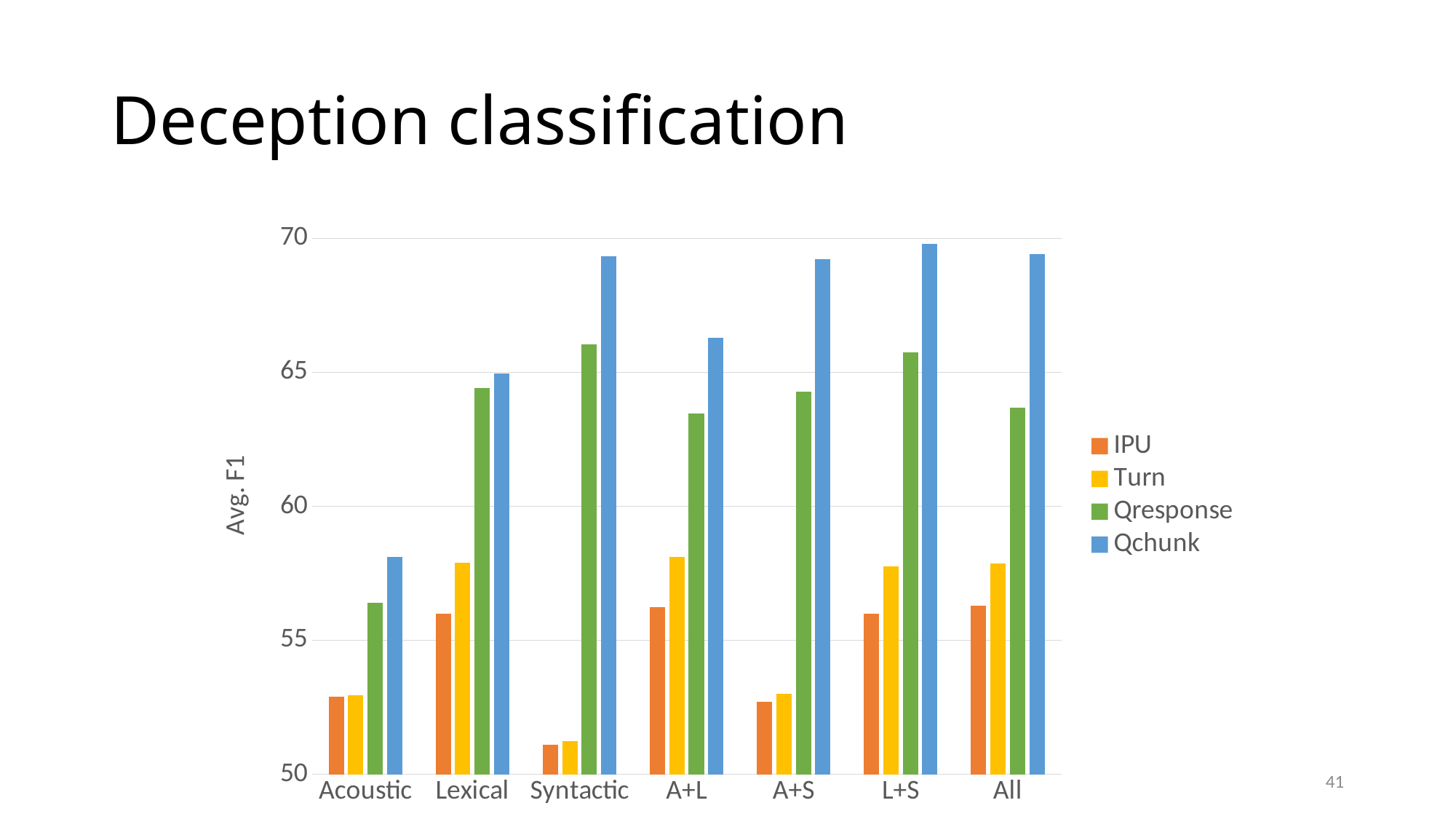
What kind of chart is shown on the slide? bar chart How many categories are shown on the x axis? 7 What is the label of the y axis? Avg. F1 Is the Qchunk value for Acoustic greater or less than 60? less Which series is shown in blue? Qchunk For which category is the Qresponse value lowest? Acoustic How many series does the legend list? 4 Is the Qresponse value for Syntactic greater or less than 65? greater For which category is the Qchunk value lowest? Acoustic For the Syntactic category, which is larger: the Qchunk value or the Qresponse value? Qchunk For which category is the IPU value lowest? Syntactic Is the Turn value for Acoustic greater or less than 55? less